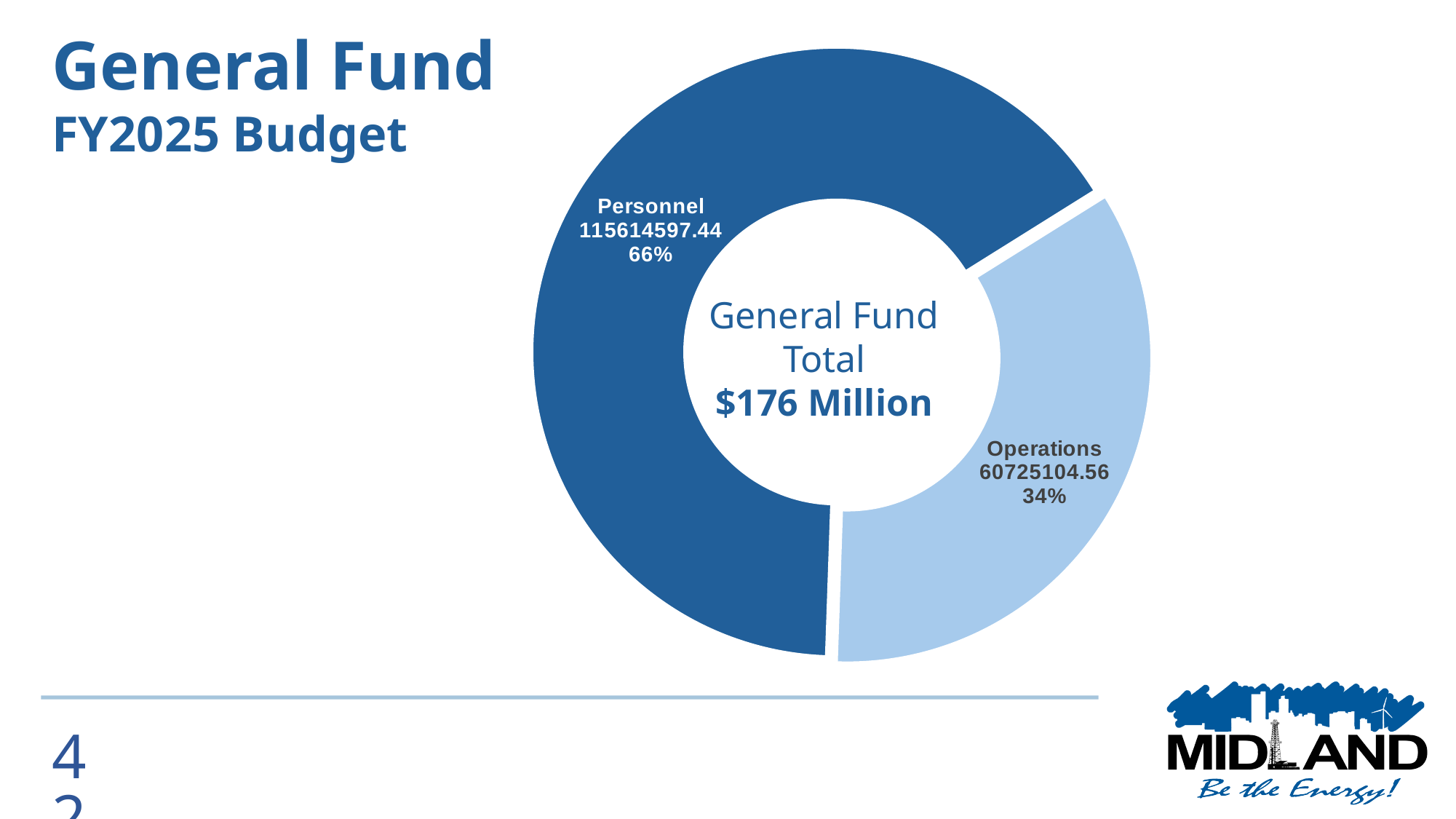
Which category has the largest slice? Personnel How many categories are shown in the chart? 2 Which is larger, Personnel or Operations? Personnel What share of the pie does Personnel represent? 66% What is the value for Operations? 60725104.56 What kind of chart is shown on the slide? Pie chart (doughnut) What is the value for Personnel? 115614597.44 What share of the pie does Operations represent? 34% What is the difference between the Personnel and Operations values? 54889492.88 Which category has the smallest slice? Operations What total is printed in the centre of the chart? $176 Million What is the title of the slide? General Fund FY2025 Budget